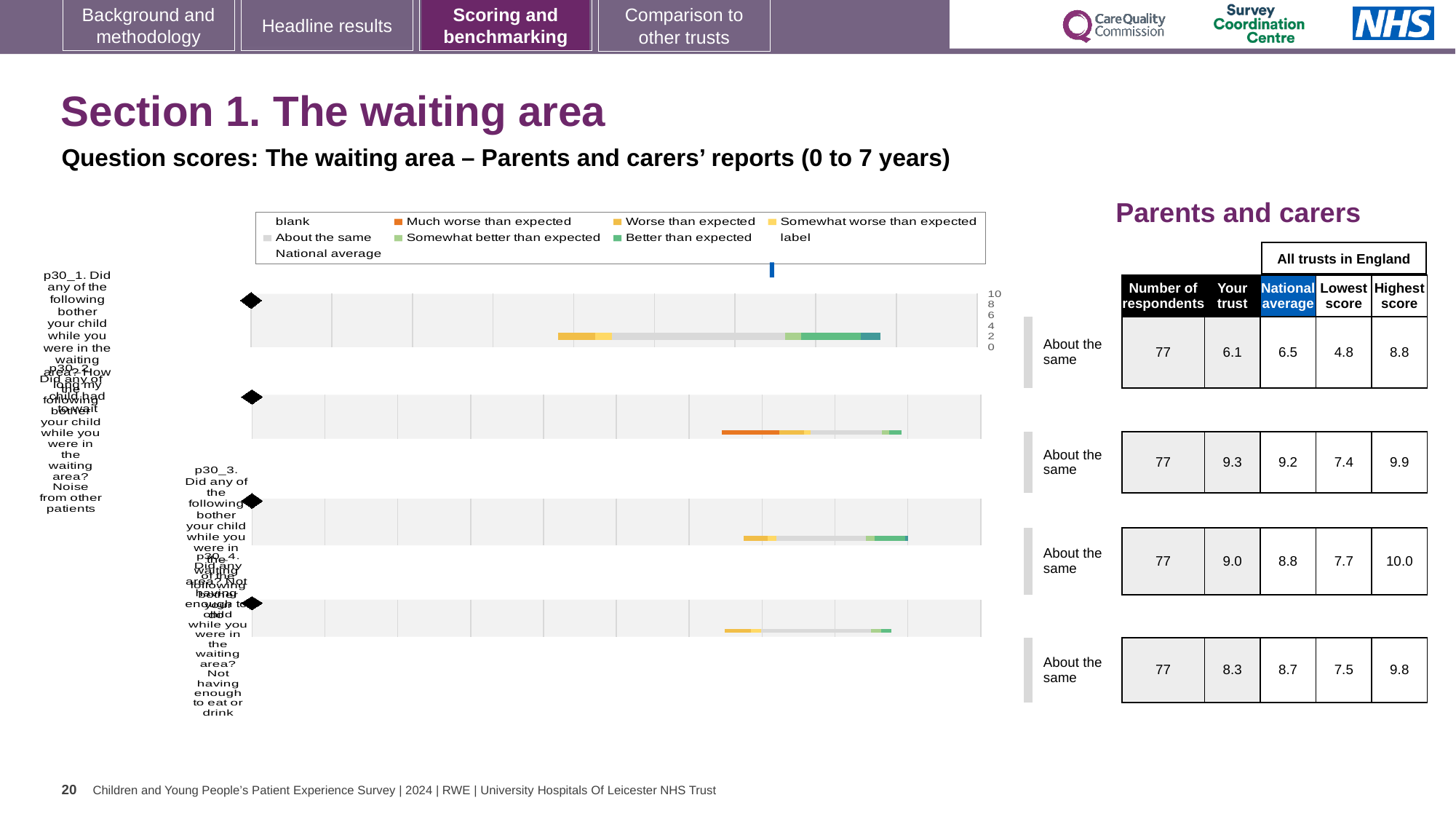
Which question row has the lowest 'Your trust' score in the table? The first row (6.1) How many question rows (bars) are plotted in the chart? 4 In the table, what is the 'Your trust' score for the first question row? 6.1 Which question row has the highest 'Your trust' score in the table? The second row (9.3) How many respondents are listed for each question row in the table? 77 How many entries does the chart legend list? 9 For the third question row, which is larger: the 'Your trust' score or the National average? Your trust (9.0) What benchmark label is shown next to each of the four bars? About the same In the table, what is the Highest score for the fourth question row? 9.8 In the table, what is the National average for the second question row? 9.2 For the first question row, what is the difference between the Highest score and the Lowest score in the table? 4.0 What kind of chart is shown on the slide? Bar chart